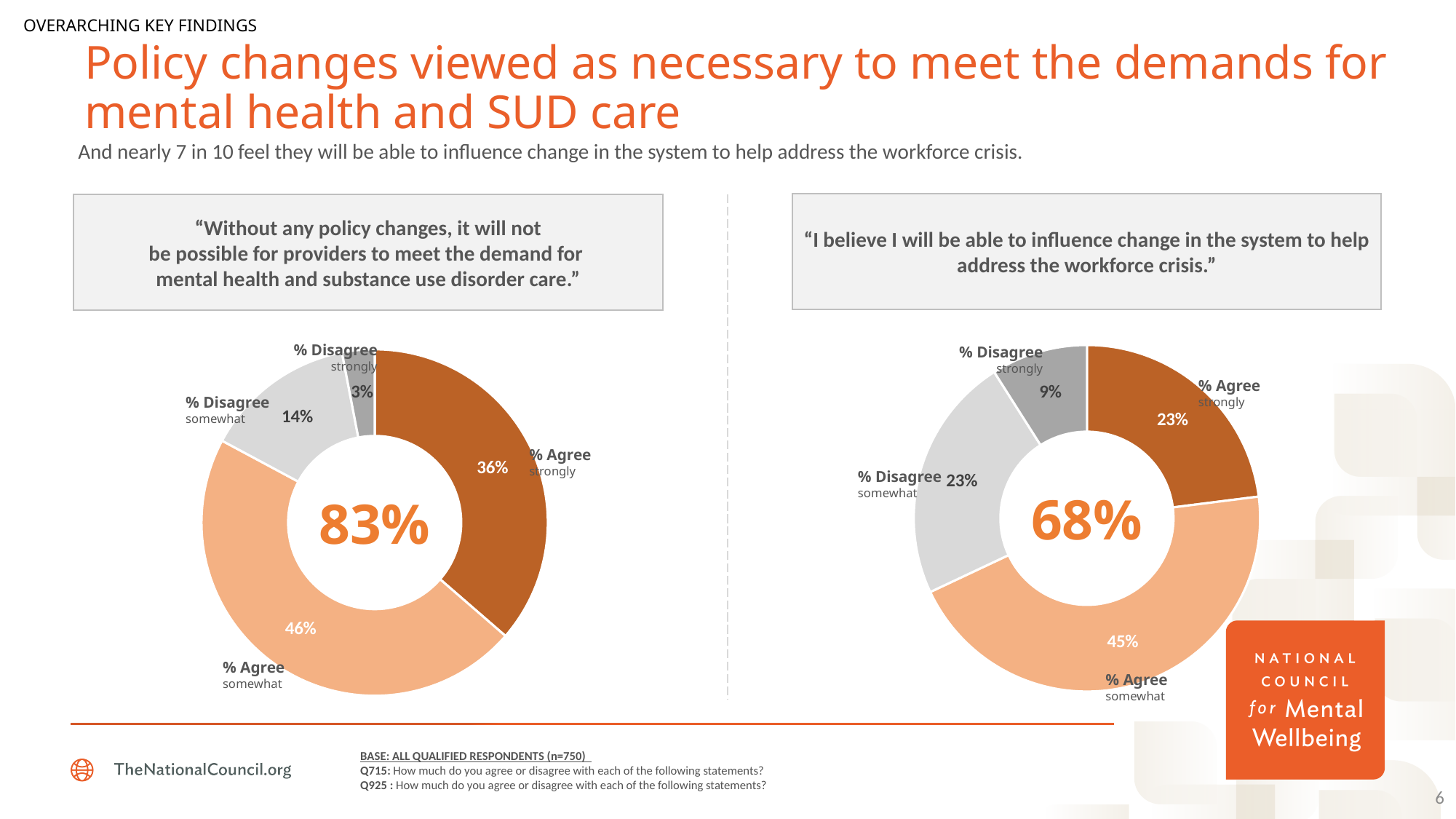
In the left chart ("Without any policy changes..."), what percentage of respondents agree strongly? 36% In the right chart ("I believe I will be able to influence change..."), which response category has the smallest share? % Disagree strongly What kind of chart is used on this slide? Donut (pie) chart In the right chart ("I believe I will be able to influence change..."), what percentage of respondents agree somewhat? 45% In the left chart ("Without any policy changes..."), what is the difference between the % Agree somewhat and % Agree strongly shares? 10% In the left chart ("Without any policy changes..."), what percentage of respondents disagree strongly? 3% In the right chart ("I believe I will be able to influence change..."), what percentage of respondents disagree strongly? 9% In the right chart ("I believe I will be able to influence change..."), what is the difference between the % Disagree somewhat and % Disagree strongly shares? 14% What total percentage is shown in the centre of the right chart ("I believe I will be able to influence change...")? 68% Which is larger: the % Disagree somewhat share in the left chart or the % Disagree somewhat share in the right chart? The right chart (23%) How many response categories does the left chart ("Without any policy changes...") show? 4 In the left chart ("Without any policy changes..."), which response category has the largest share? % Agree somewhat